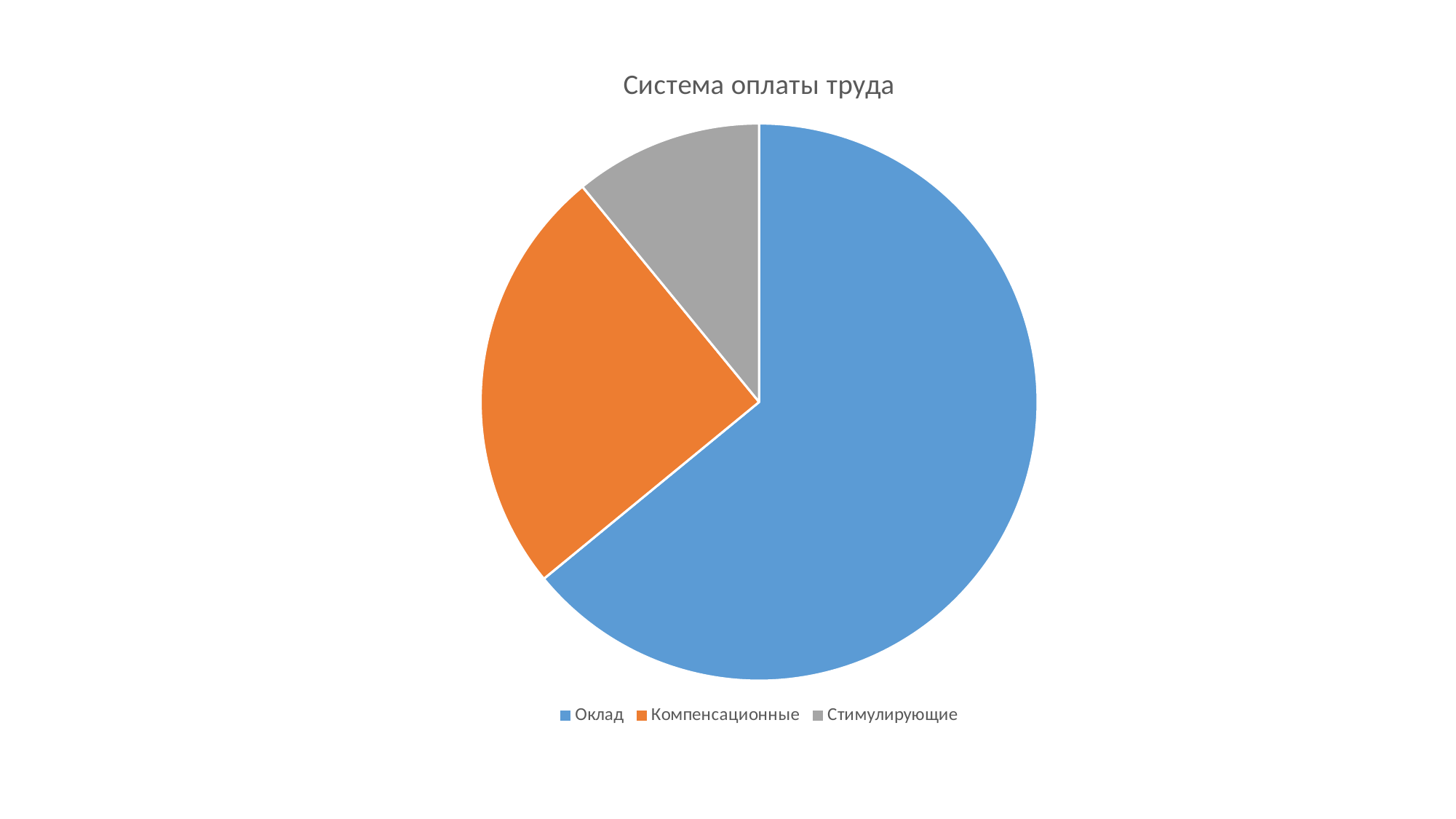
Which category has the largest slice of the pie? Оклад How many entries does the legend list? 3 How many slices does the pie chart have? 3 Which category has the smallest slice of the pie? Стимулирующие What is the title of the chart? Система оплаты труда What colour is the slice for Оклад? blue Which slice is larger, Оклад or Компенсационные? Оклад Which slice is larger, Компенсационные or Стимулирующие? Компенсационные What kind of chart is shown on the slide? pie chart